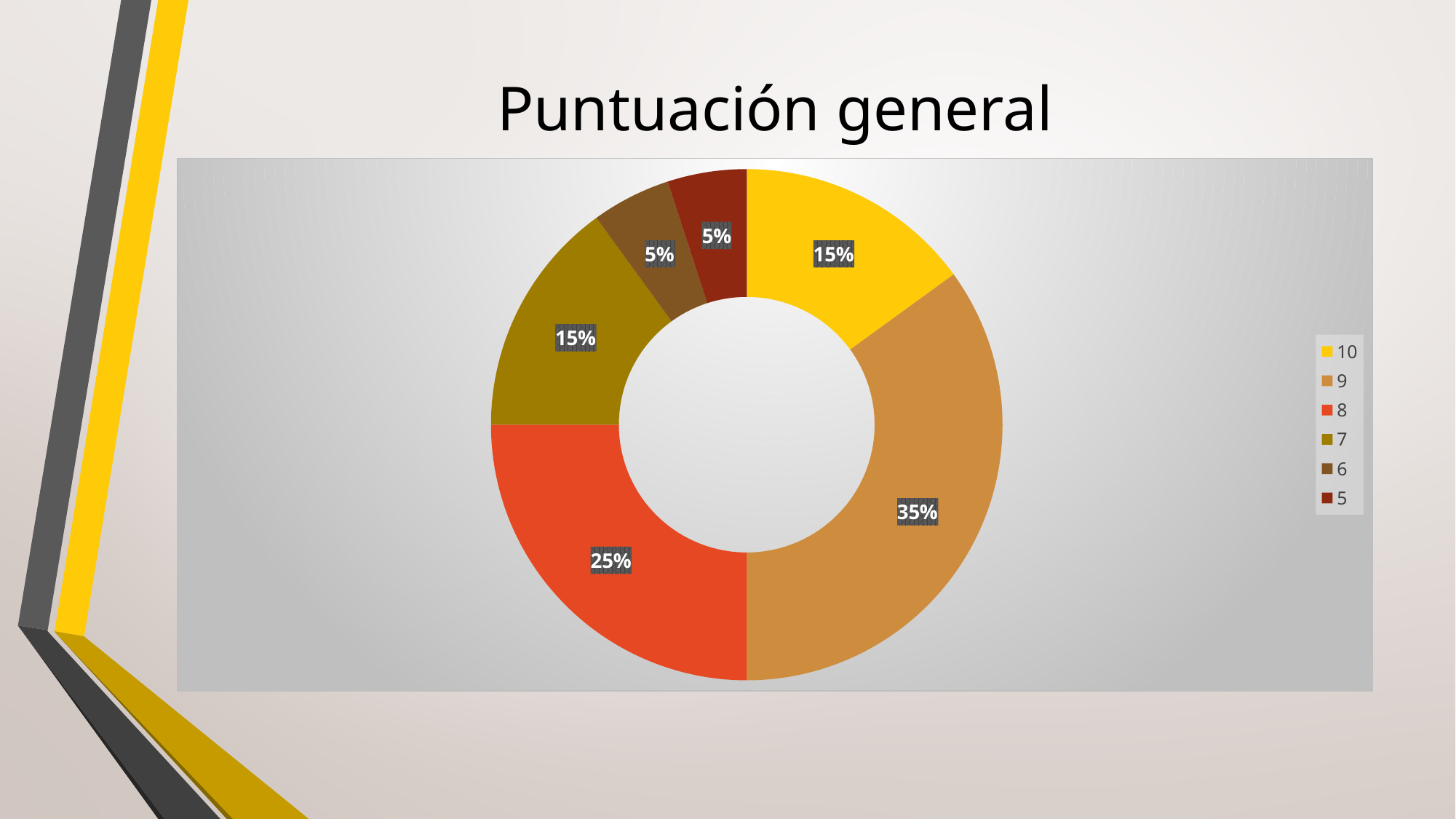
What share of the chart does the category 5 represent? 5% What colour is the slice for category 8? Orange-red Which has a larger share, category 10 or category 6? 10 What share of the chart does the category 8 represent? 25% What is the title of the slide? Puntuación general What kind of chart is shown on the slide? Doughnut chart What share of the chart does the category 10 represent? 15% What is the difference in share between category 8 and category 7? 10% What is the difference in share between category 9 and category 8? 10% How many categories does the chart show? 6 What share of the chart does the category 9 represent? 35% Which category has the largest share of the chart? 9